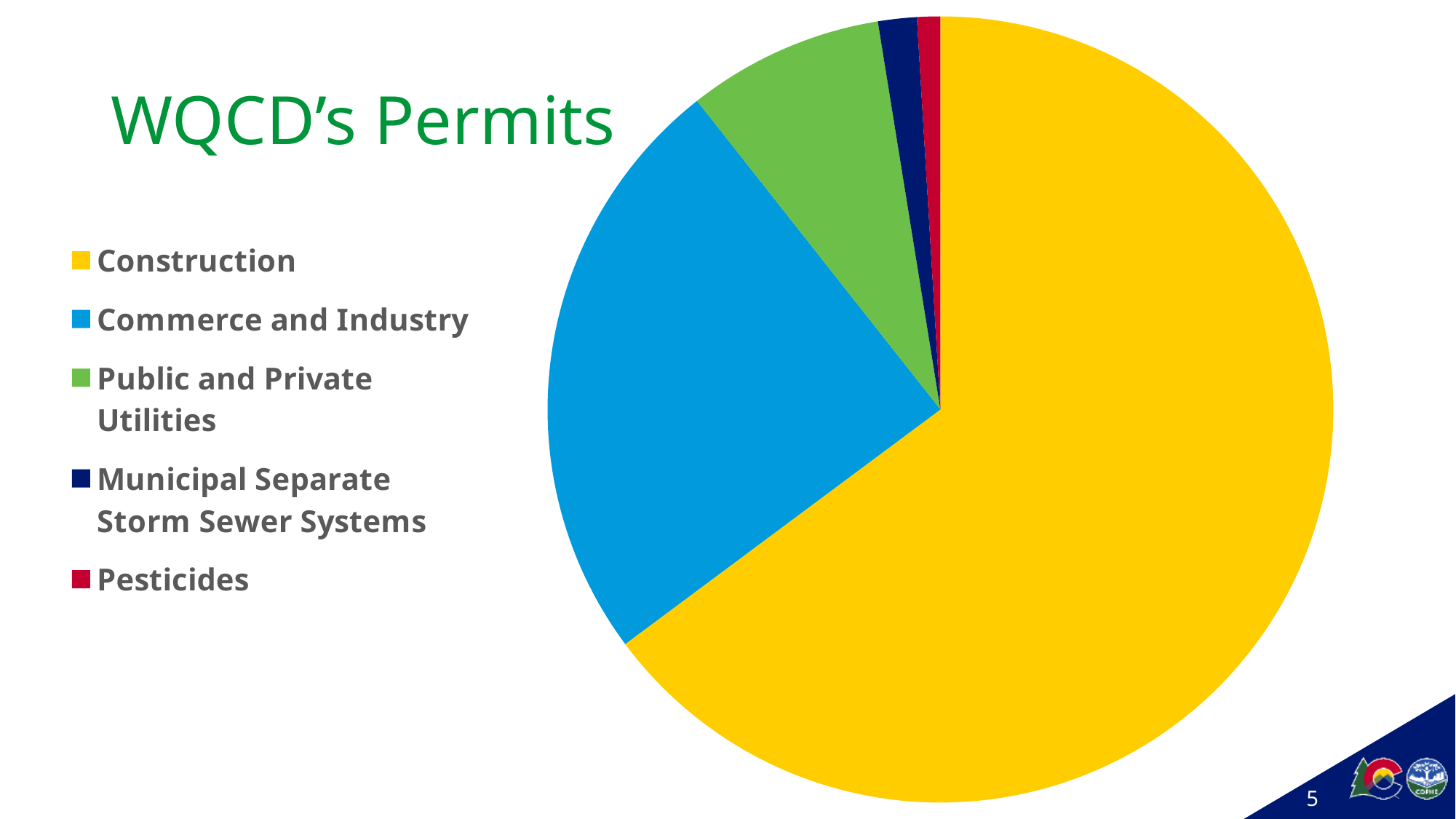
What colour represents Commerce and Industry in the pie chart? Blue What kind of chart is shown on the slide? Pie chart Which is larger, the slice for Municipal Separate Storm Sewer Systems or the slice for Pesticides? Municipal Separate Storm Sewer Systems Which category has the largest slice of the pie? Construction Which is larger, the slice for Public and Private Utilities or the slice for Municipal Separate Storm Sewer Systems? Public and Private Utilities Which category has the smallest slice of the pie? Pesticides Which category is the second largest slice of the pie? Commerce and Industry Which is larger, the slice for Commerce and Industry or the slice for Public and Private Utilities? Commerce and Industry Is the Construction slice greater or less than half of the pie? greater What is the title of the chart on the slide? WQCD's Permits How many categories does the pie chart show? 5